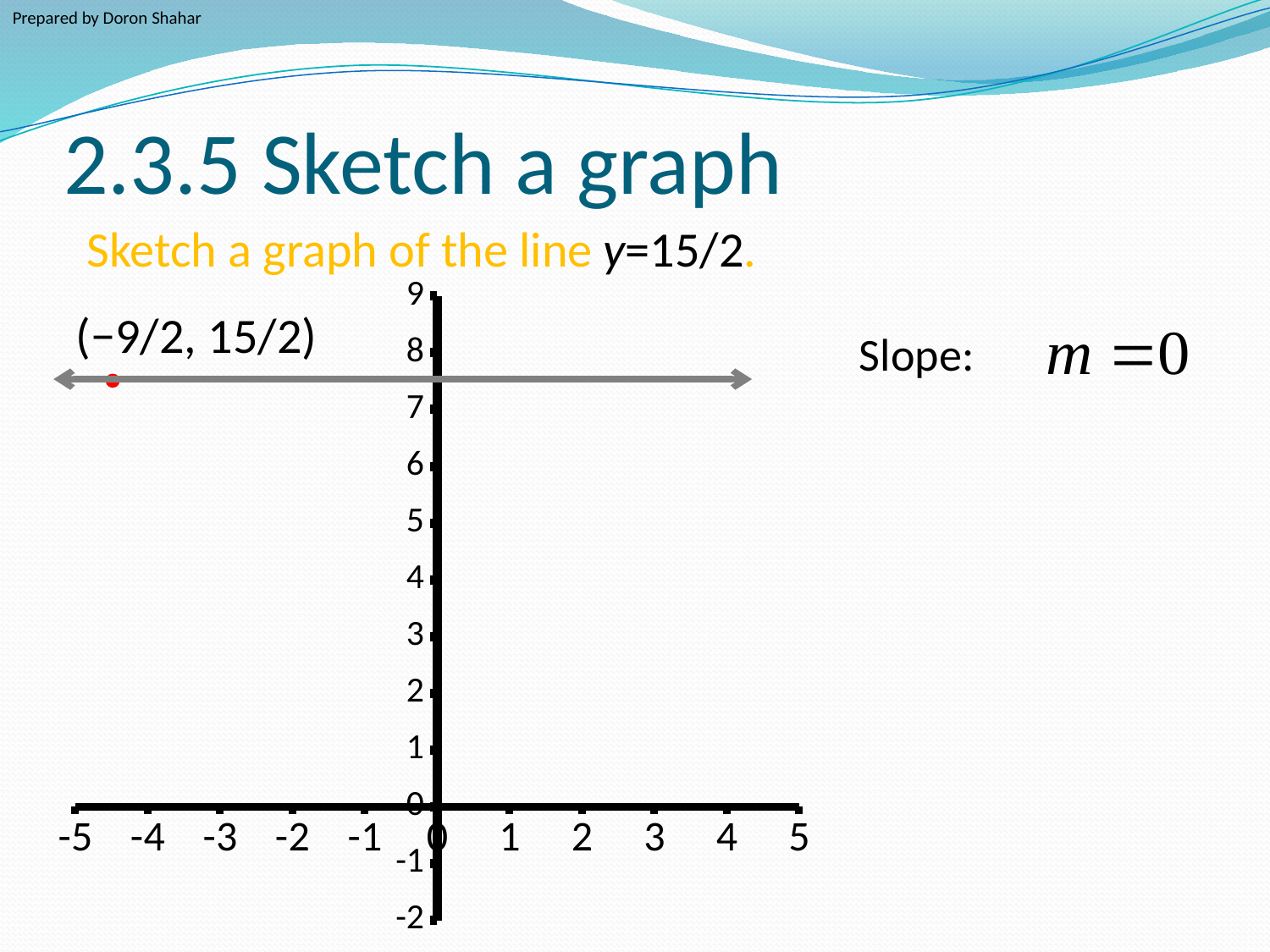
How many points are marked with a red dot on the graph? 1 What are the coordinates of the labeled point on the graph? (−9/2, 15/2) What is the lowest value labeled on the x axis? -5 What is the equation of the line sketched on the graph? y=15/2 Is the y-value of the horizontal line greater or less than 8? less Is the y-value of the horizontal line greater or less than 7? greater Does the plotted line rise, fall, or stay flat as x increases? stay flat Is the x-coordinate of the red point greater or less than -4? less What is the slope of the line shown on the slide? m = 0 What kind of chart is shown on the slide? line chart What is the highest value labeled on the y axis? 9